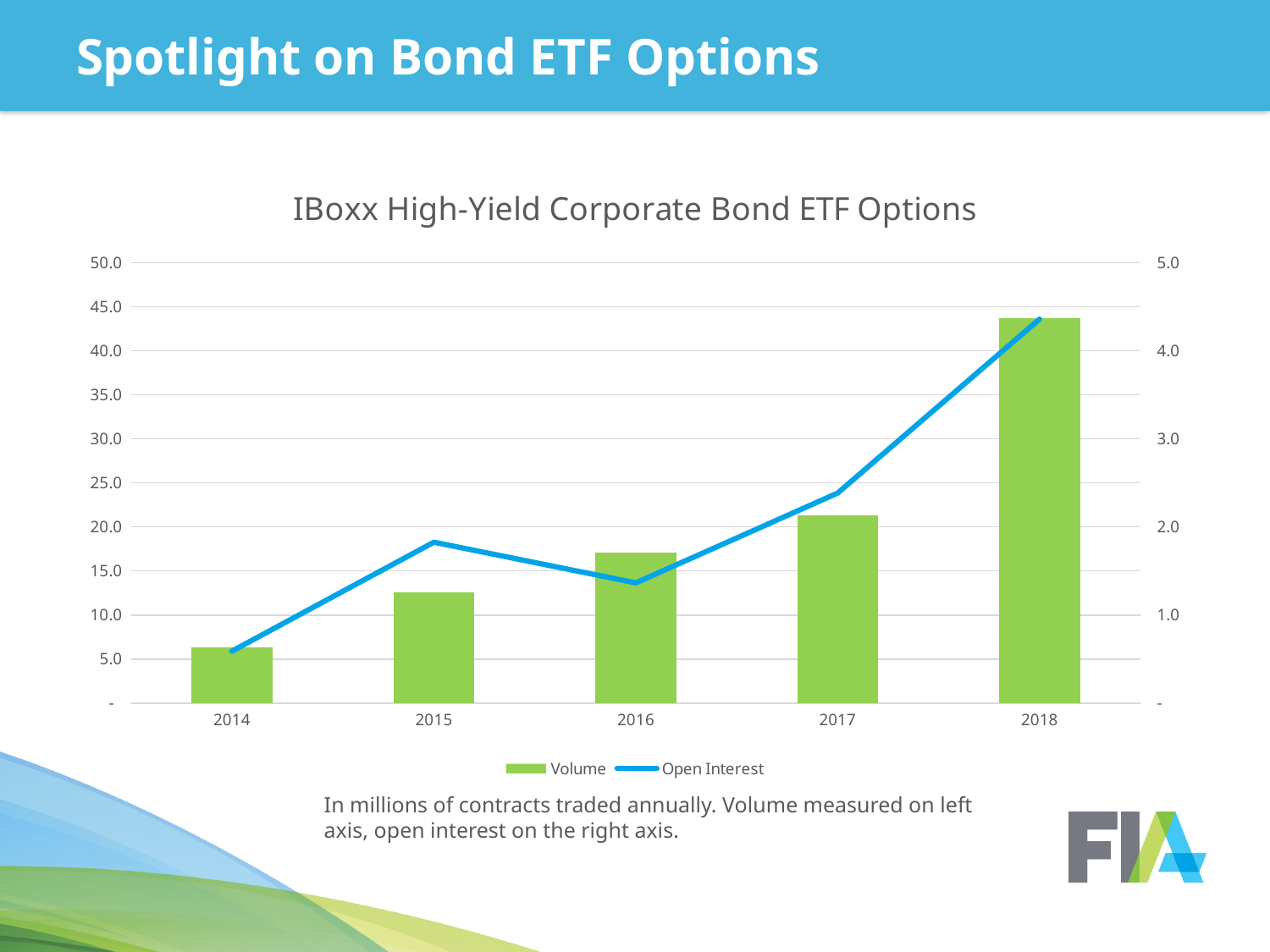
Which year has the lowest Volume bar? 2014 Is the Volume for 2018 greater or less than 40.0? greater Which year has the highest Volume bar? 2018 What is the title of the chart? IBoxx High-Yield Corporate Bond ETF Options Which year has higher Open Interest, 2015 or 2016? 2015 How many series does the chart legend list? 2 Is the Volume for 2014 greater or less than 10.0? less Does the Volume rise or fall from 2014 to 2018? rise Is the Open Interest for 2016 greater or less than 2.0 on the right axis? less How many years are shown on the x axis of the chart? 5 Which year has a larger Volume, 2015 or 2017? 2017